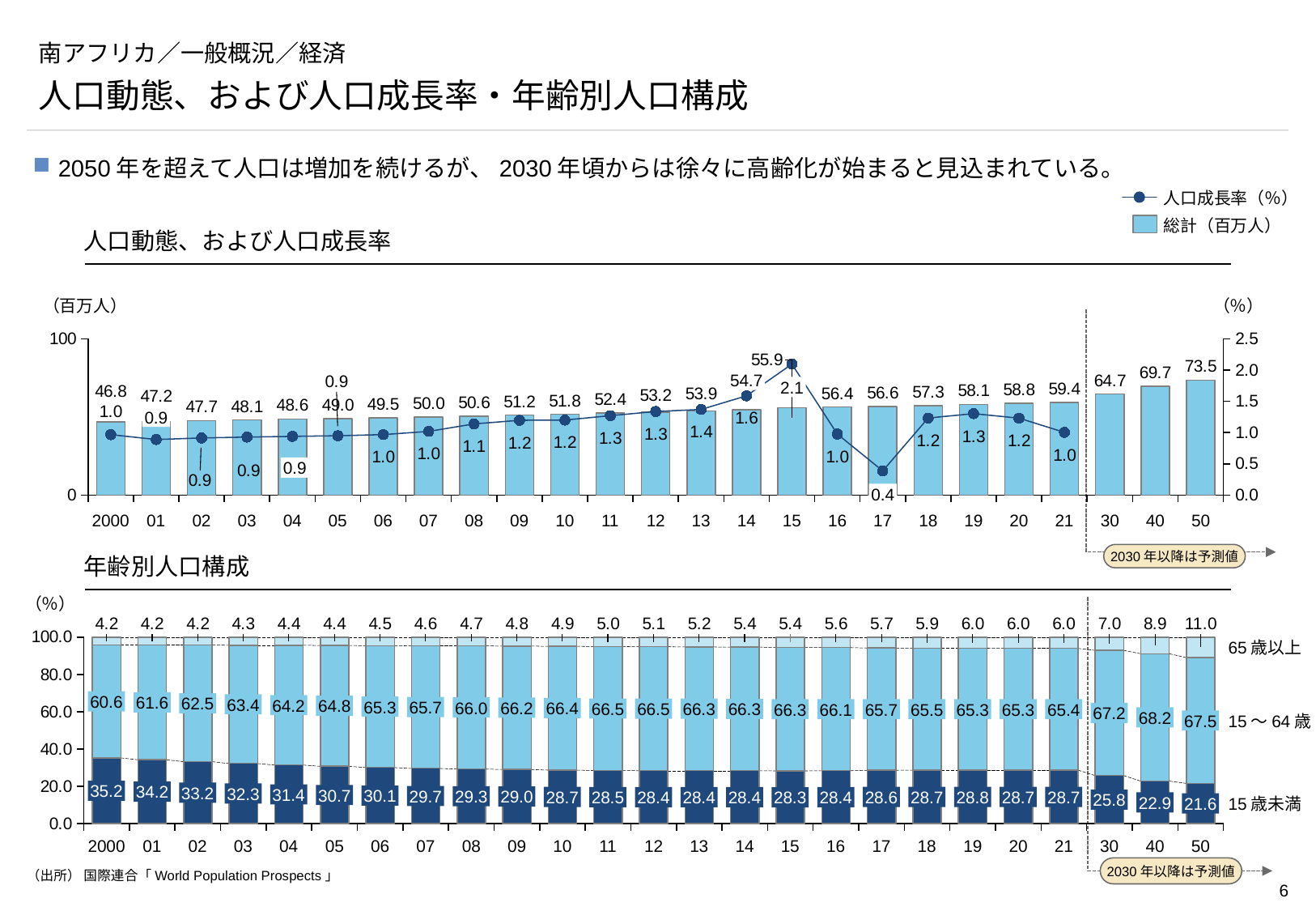
In the top chart (人口動態、および人口成長率), what is the total population (百万人) for 2000? 46.8 In the top chart (人口動態、および人口成長率), what is the difference in total population (百万人) between 2050 and 2000? 26.7 In the bottom chart (年齢別人口構成), which is larger, the 15～64歳 share in 2040 or in 2050? 2040 In the top chart (人口動態、および人口成長率), do the total population bars rise or fall from 2000 to 2050? rise In the top chart (人口動態、および人口成長率), in which year is the population growth rate (%) lowest? 2017 In the top chart (人口動態、および人口成長率), what is the total population (百万人) projected for 2050? 73.5 In the bottom chart (年齢別人口構成), what is the share of the population under 15 (15歳未満) in 2000? 35.2 In the top chart (人口動態、および人口成長率), how many series does the legend list? 2 In the top chart (人口動態、および人口成長率), in which year is the population growth rate (%) highest? 2015 In the bottom chart (年齢別人口構成), what is the share of the population aged 65 and over (65歳以上) in 2050? 11.0 What kind of chart is the bottom chart (年齢別人口構成)? stacked bar chart In the bottom chart (年齢別人口構成), what is the total of the stacked bar for 2000? 100.0